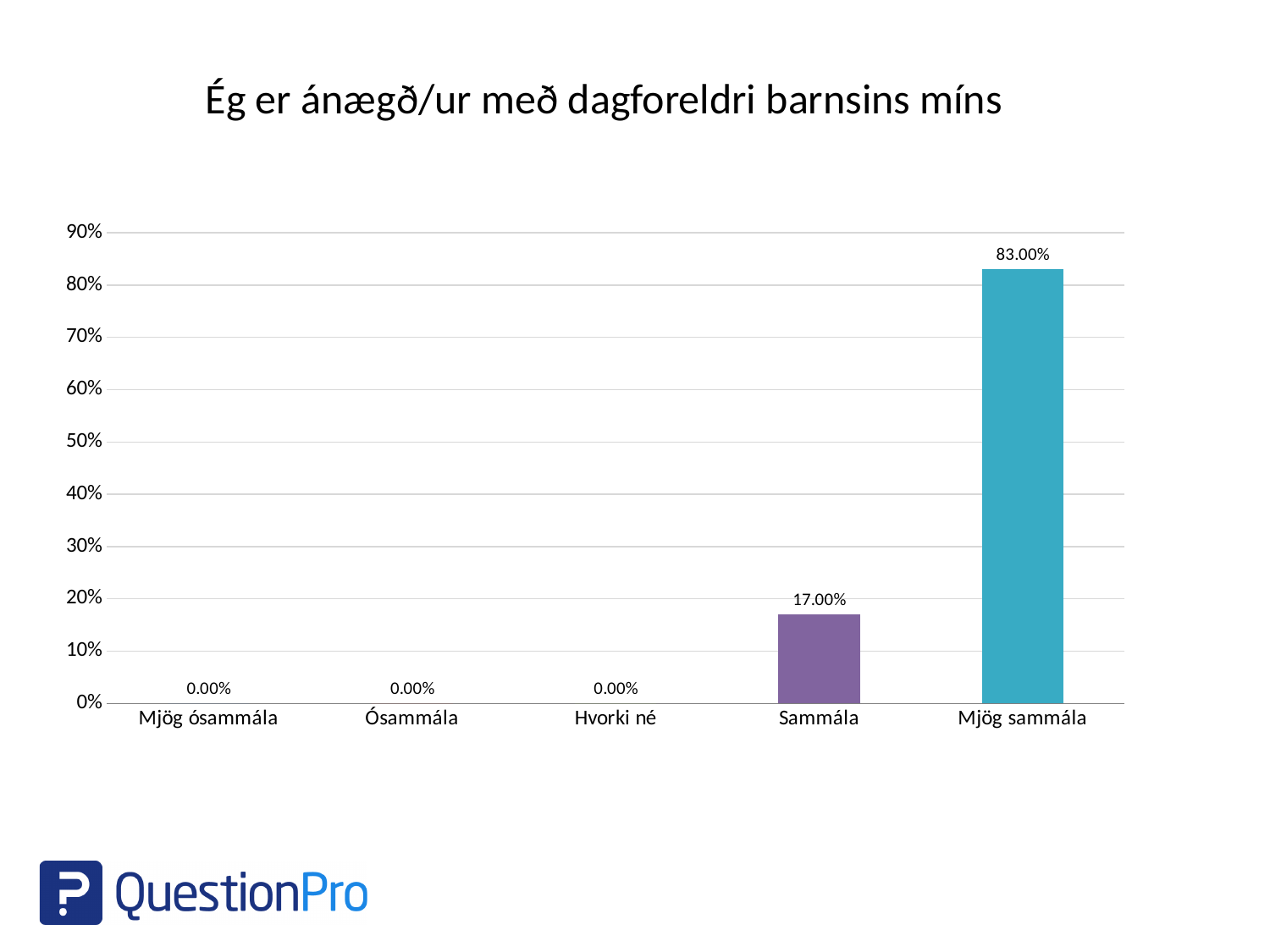
How many categories have a value of 0.00%? 3 What is the value for Sammála? 17.00% What is the value for Hvorki né? 0.00% Is the value for Mjög sammála greater or less than 80%? greater How many categories are shown on the x axis? 5 What is the value for Mjög sammála? 83.00% What is the title of the chart? Ég er ánægð/ur með dagforeldri barnsins míns Is the value for Sammála greater or less than 20%? less Which is larger, the value for Sammála or the value for Mjög sammála? Mjög sammála What is the difference between the values for Mjög sammála and Sammála? 66.00% Which category has the highest value? Mjög sammála What kind of chart is shown on the slide? bar chart